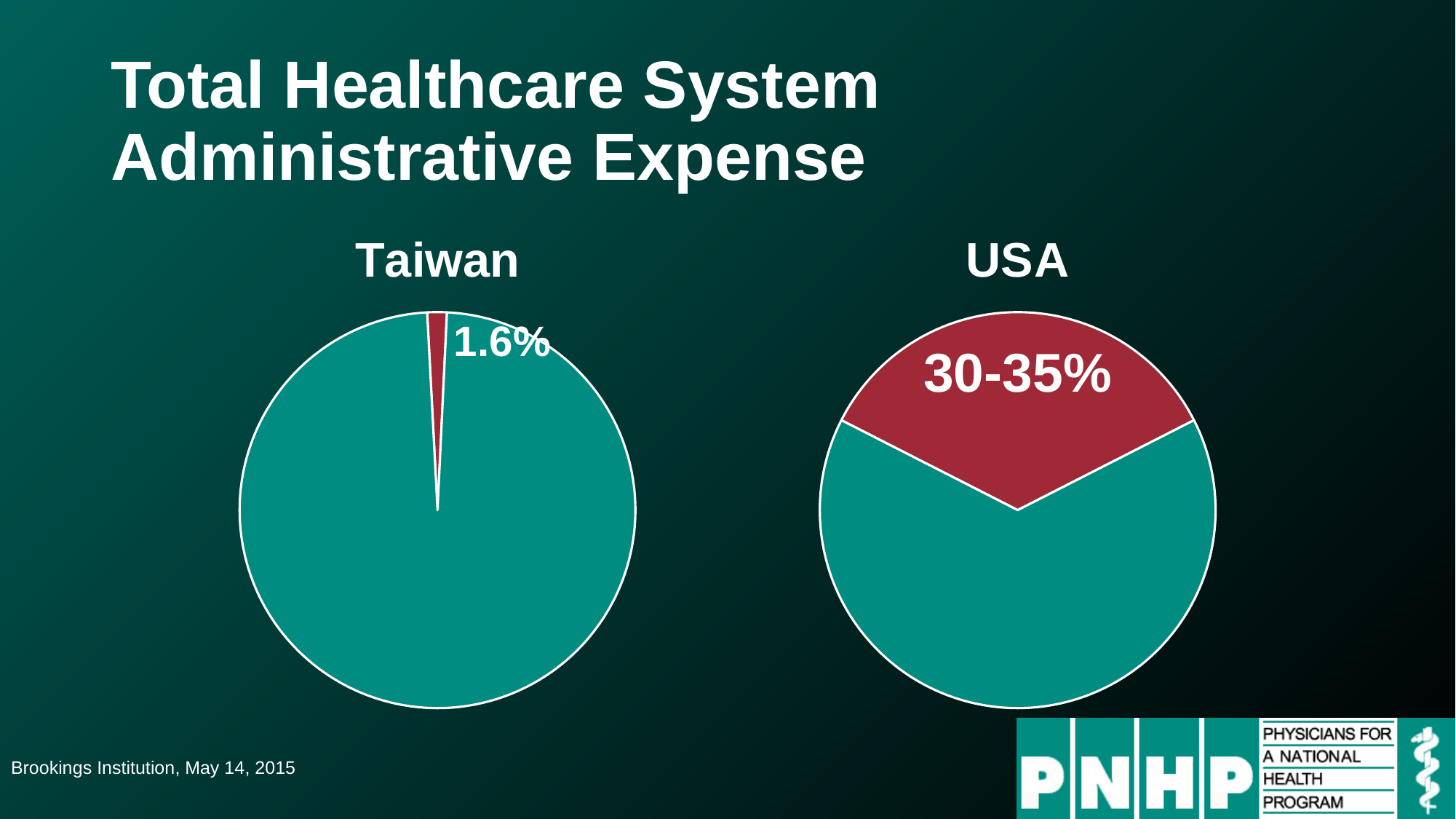
Which country's chart shows the larger administrative expense share, Taiwan or USA? USA What is the title of the slide containing the two pie charts? Total Healthcare System Administrative Expense How many pie charts are shown on the slide? 2 In the USA pie chart, is the red slice greater or less than 50% of the pie? less What kind of chart is used for Taiwan on this slide? Pie chart How many slices does the Taiwan pie chart have? 2 Which country's chart shows the smaller administrative expense share? Taiwan What kind of chart is used for USA on this slide? Pie chart What colour is the slice labelled 30-35% in the USA pie chart? Red How many slices does the USA pie chart have? 2 In the Taiwan pie chart, what percentage is shown for the red slice? 1.6% In the USA pie chart, what percentage is shown for the red slice? 30-35%